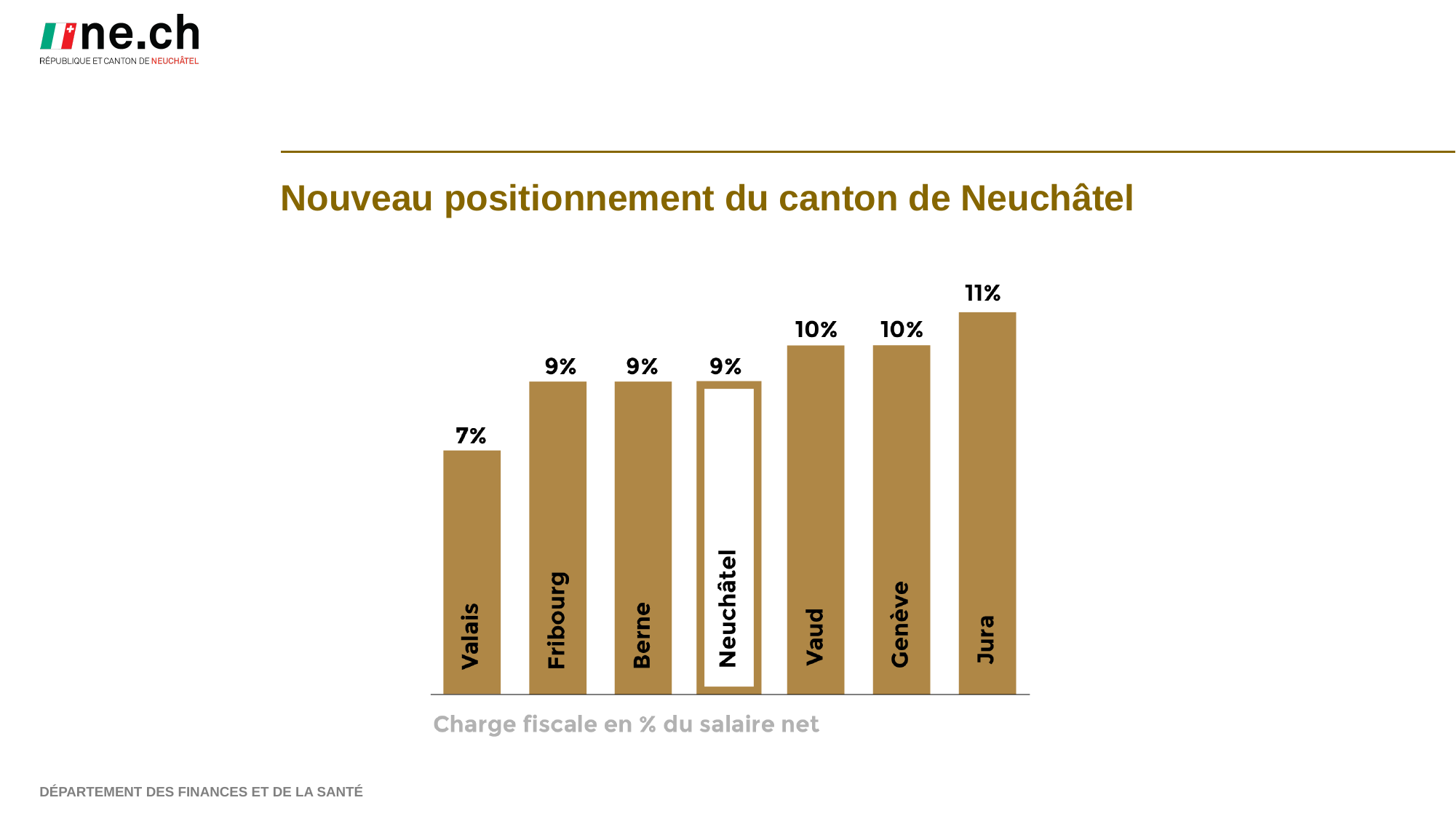
Which is larger, the value for Genève or the value for Berne? Genève What is the value for Neuchâtel? 9% What is the value for Jura? 11% Which canton has the highest value? Jura What is the value for Valais? 7% What is the value for Vaud? 10% Which canton has the lowest value? Valais Do the values generally rise or fall from left to right along the x axis? Rise What kind of chart is shown on the slide? Bar chart How many cantons are shown in the chart? 7 What is the difference between the values for Jura and Valais? 4% What is the caption below the chart's x axis? Charge fiscale en % du salaire net